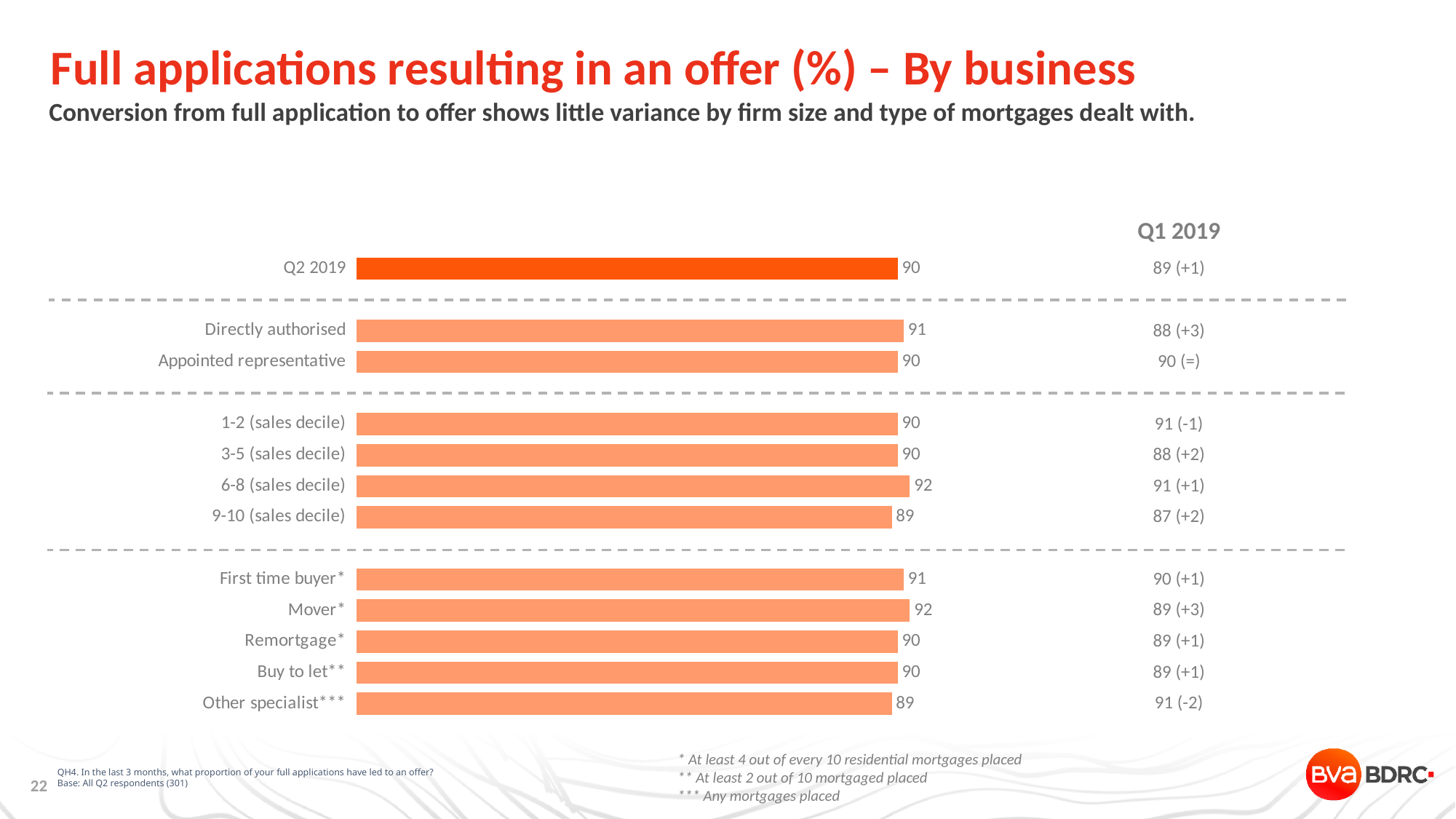
What is the value for Directly authorised? 91 What is the difference between the values for Directly authorised and Appointed representative? 1 What is the value for 6-8 (sales decile)? 92 What is the title of the slide's chart? Full applications resulting in an offer (%) – By business What is the value for Q2 2019 overall? 90 How many bars are plotted in the chart? 12 Which has the larger value, 6-8 (sales decile) or 9-10 (sales decile)? 6-8 (sales decile) Which has the larger value, Mover or Remortgage? Mover What is the value for Other specialist? 89 What type of chart is shown on the slide? bar chart What is the Q1 2019 value shown for Mover? 89 (+3) What is the highest value shown on any bar in the chart? 92